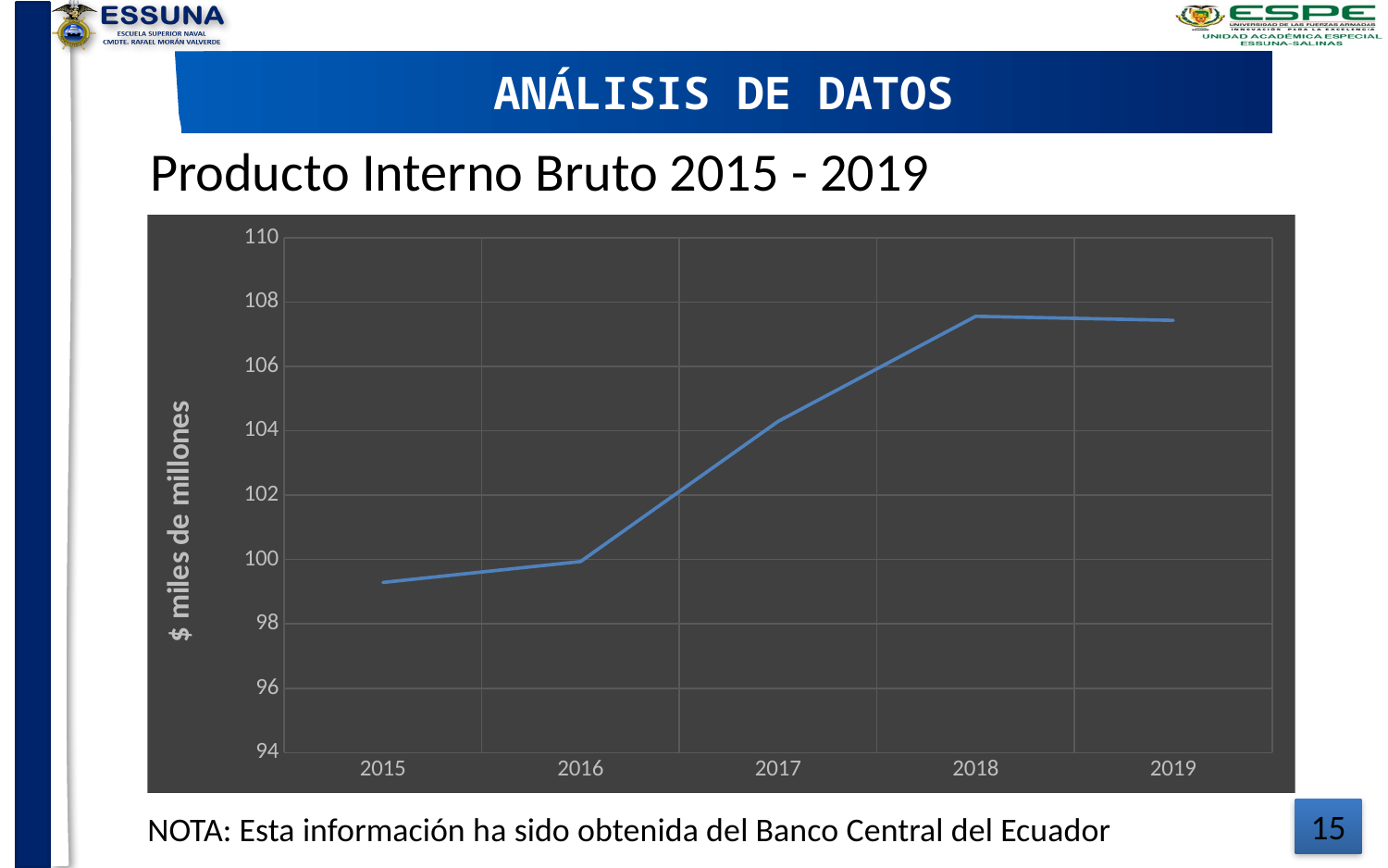
Which year has the larger value, 2016 or 2018? 2018 Is the value for 2016 greater or less than 102? less What is the label on the y axis of the chart? $ miles de millones Is the value for 2018 greater or less than 106? greater What kind of chart is shown on the slide? line chart What is the title of the chart? Producto Interno Bruto 2015 - 2019 How many years are plotted on the x axis of the chart? 5 Is the value for 2019 greater or less than 106? greater Which year has the larger value, 2015 or 2017? 2017 Does the line generally rise or fall from 2015 to 2018? rise